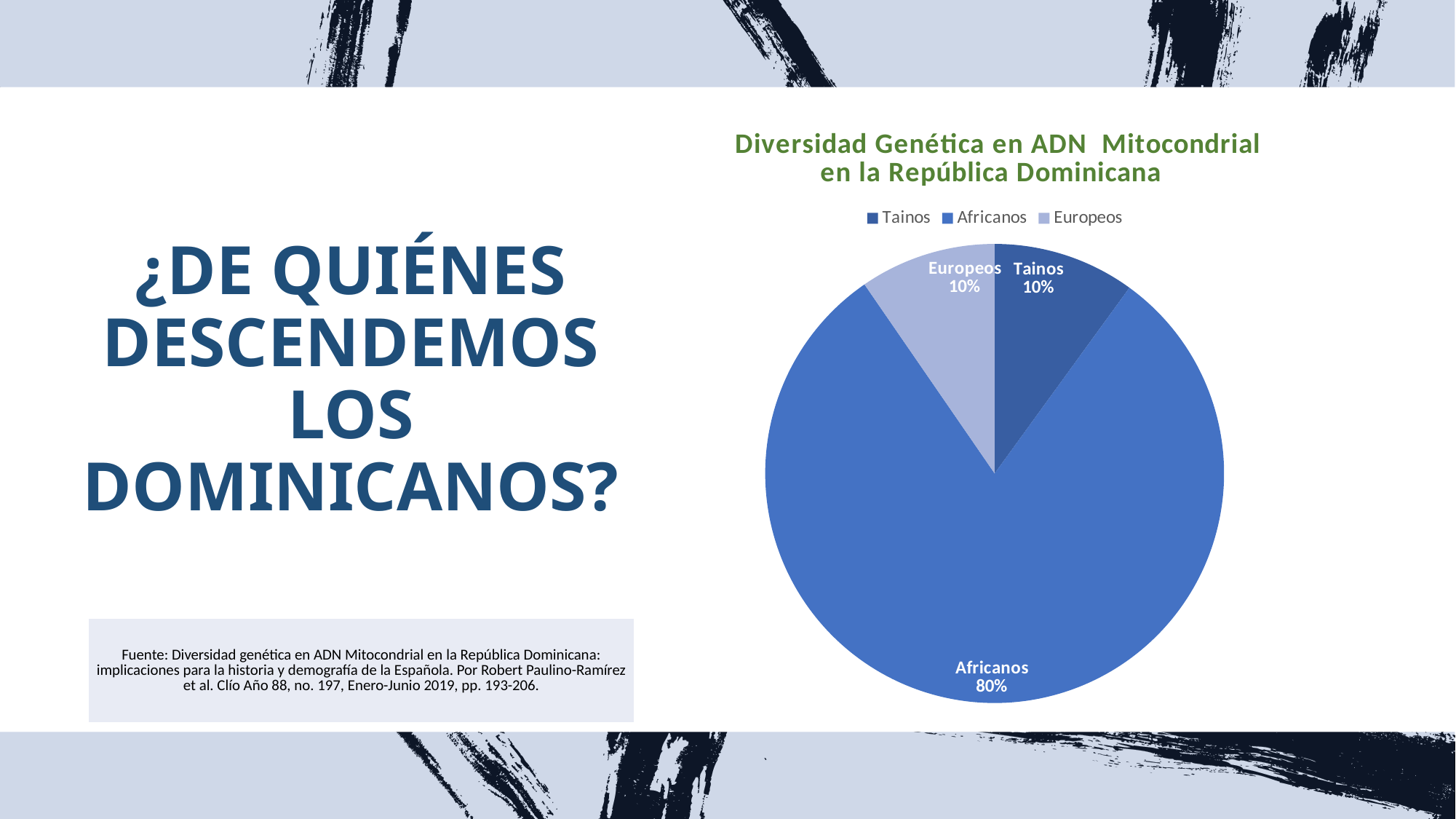
What share of the pie does Europeos represent? 10% Which category has the largest slice of the pie? Africanos Which is larger, the Africanos slice or the Europeos slice? Africanos How many categories does the pie chart show? 3 What share of the pie does Africanos represent? 80% What is the combined share of Tainos and Europeos? 20% What is the difference between the Africanos share and the Tainos share? 70% Which legend entry is shown in the lightest blue colour? Europeos What kind of chart is shown on the slide? pie chart What is the title of the chart? Diversidad Genética en ADN Mitocondrial en la República Dominicana How many entries does the legend list? 3 What share of the pie does Tainos represent? 10%